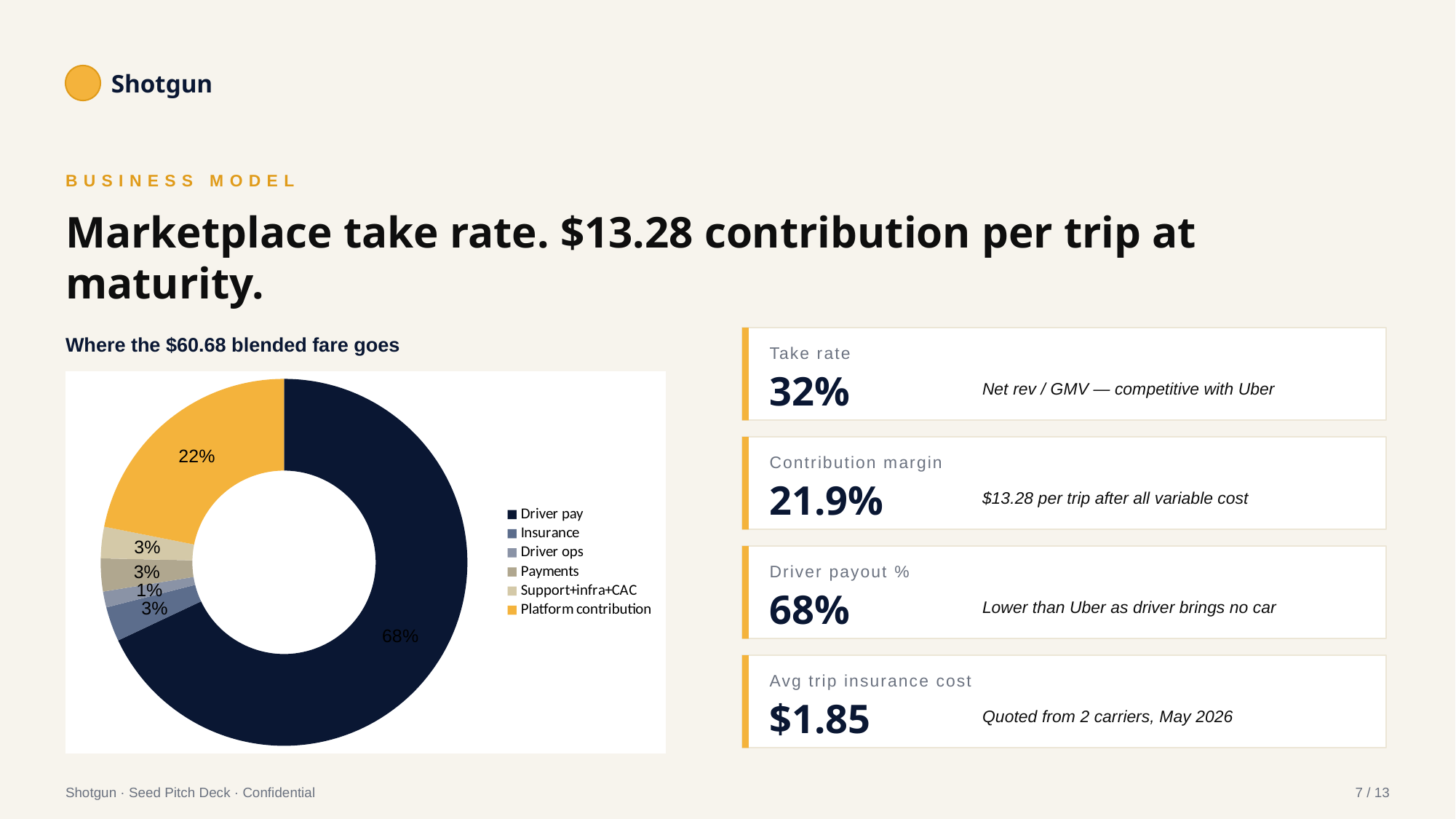
Which category takes the largest share of the blended fare? Driver pay Which is larger, the share for Platform contribution or the share for Payments? Platform contribution What share of the blended fare is Platform contribution? 22% What kind of chart is shown under "Where the $60.68 blended fare goes"? Pie chart (donut) How many percentage points larger is the Driver pay share than the Platform contribution share? 46 What share of the blended fare goes to Insurance? 3% What share of the blended fare goes to Driver pay? 68% What share of the blended fare goes to Driver ops? 1% Which category takes the smallest share of the blended fare? Driver ops How many entries does the pie chart's legend list? 6 How many slices does the pie chart have? 6 What is the title of the pie chart? Where the $60.68 blended fare goes